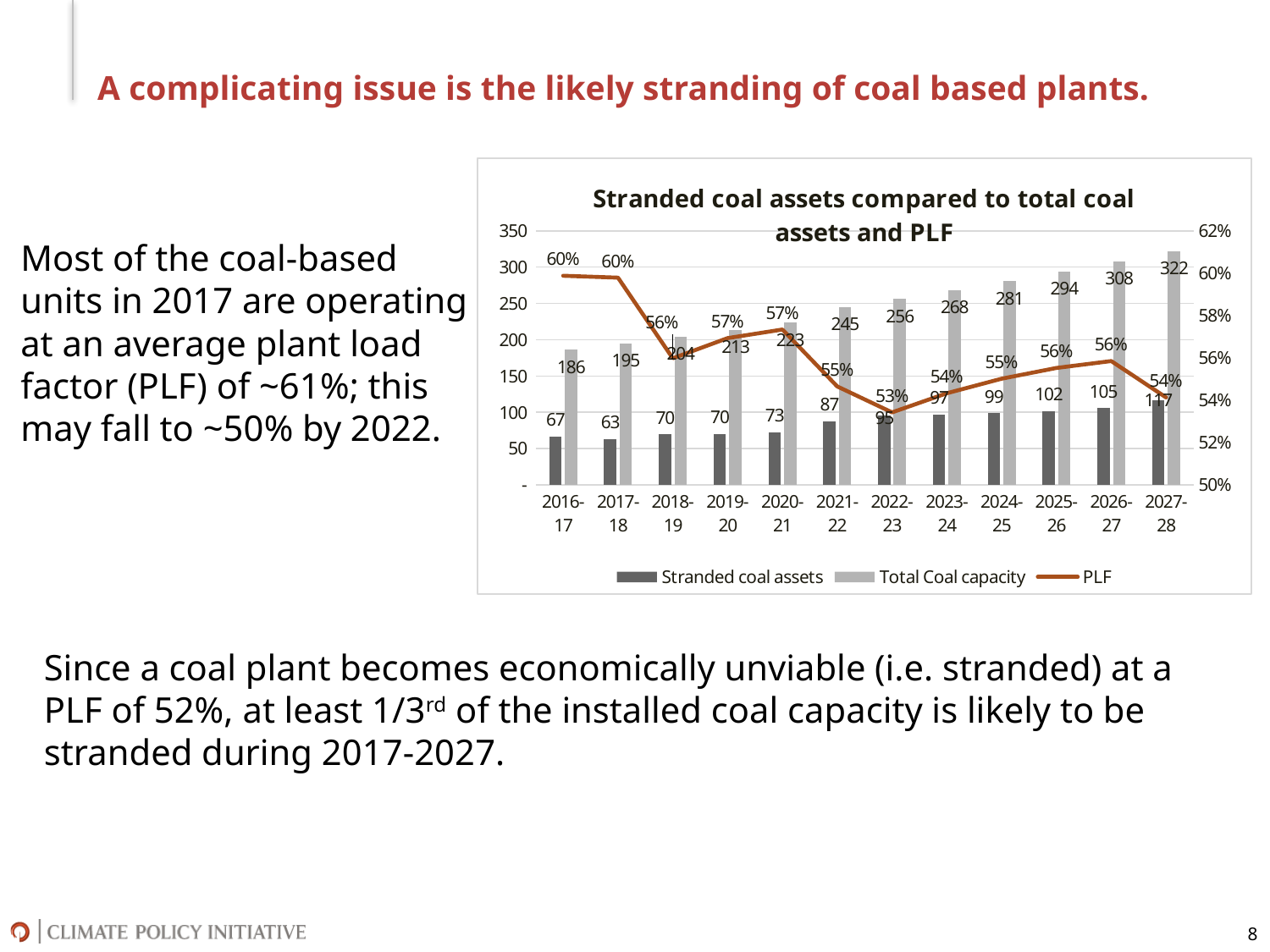
How many years are shown on the x axis of the chart? 12 Does Total Coal capacity rise or fall from 2016-17 to 2027-28? rise What is the difference between Stranded coal assets in 2022-23 and in 2016-17? 28 What is the difference between Total Coal capacity in 2027-28 and in 2016-17? 136 Which year has a larger Stranded coal assets value, 2023-24 or 2025-26? 2025-26 In which year is the PLF lowest? 2022-23 What is the Stranded coal assets value for 2021-22? 87 What is the Total Coal capacity value for 2020-21? 223 What is the PLF value for 2022-23? 53% How many series does the chart legend list? 3 In which year is the Stranded coal assets value lowest? 2017-18 In which year is Total Coal capacity highest? 2027-28